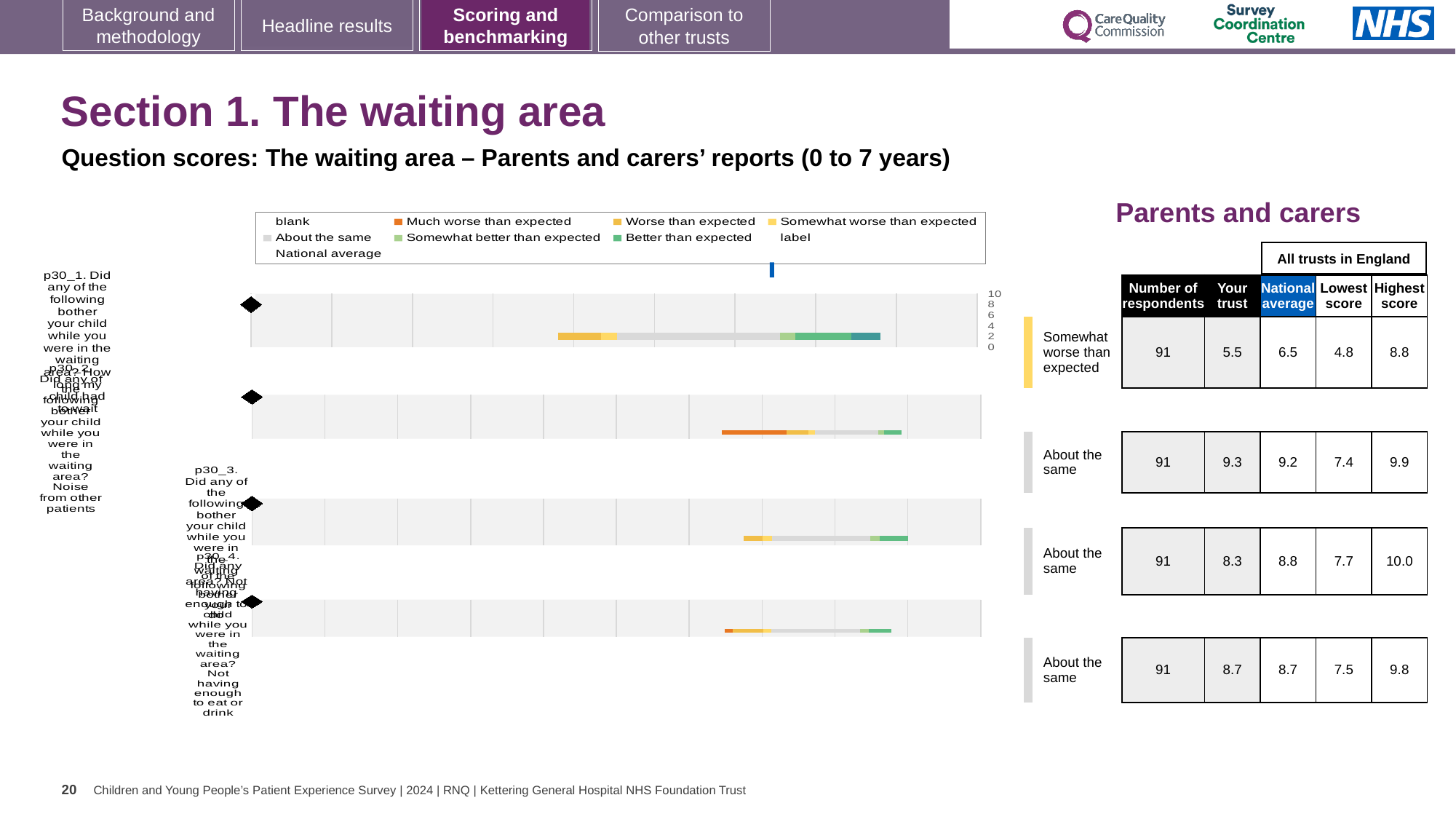
What is the 'Your trust' score for the first question, rated 'Somewhat worse than expected'? 5.5 Which question has the lowest 'Your trust' score? p30_1 (How long my child had to wait), 5.5 For the second question (p30_2), is the 'Your trust' score (9.3) larger or smaller than the national average (9.2)? larger What is the difference between the highest score (8.8) and the lowest score (4.8) for the first question? 4.0 What is the highest score across all trusts in England for the third question (p30_3)? 10.0 What is the title of the table to the right of the chart? Parents and carers What kind of chart is shown on the slide? bar chart What is the national average for the first question, rated 'Somewhat worse than expected'? 6.5 How many respondents answered each of the questions in the table? 91 Which question has the highest 'Your trust' score? p30_2 (Noise from other patients), 9.3 Which colour in the legend represents 'Much worse than expected'? orange How many questions (rows) are plotted in the chart? 4